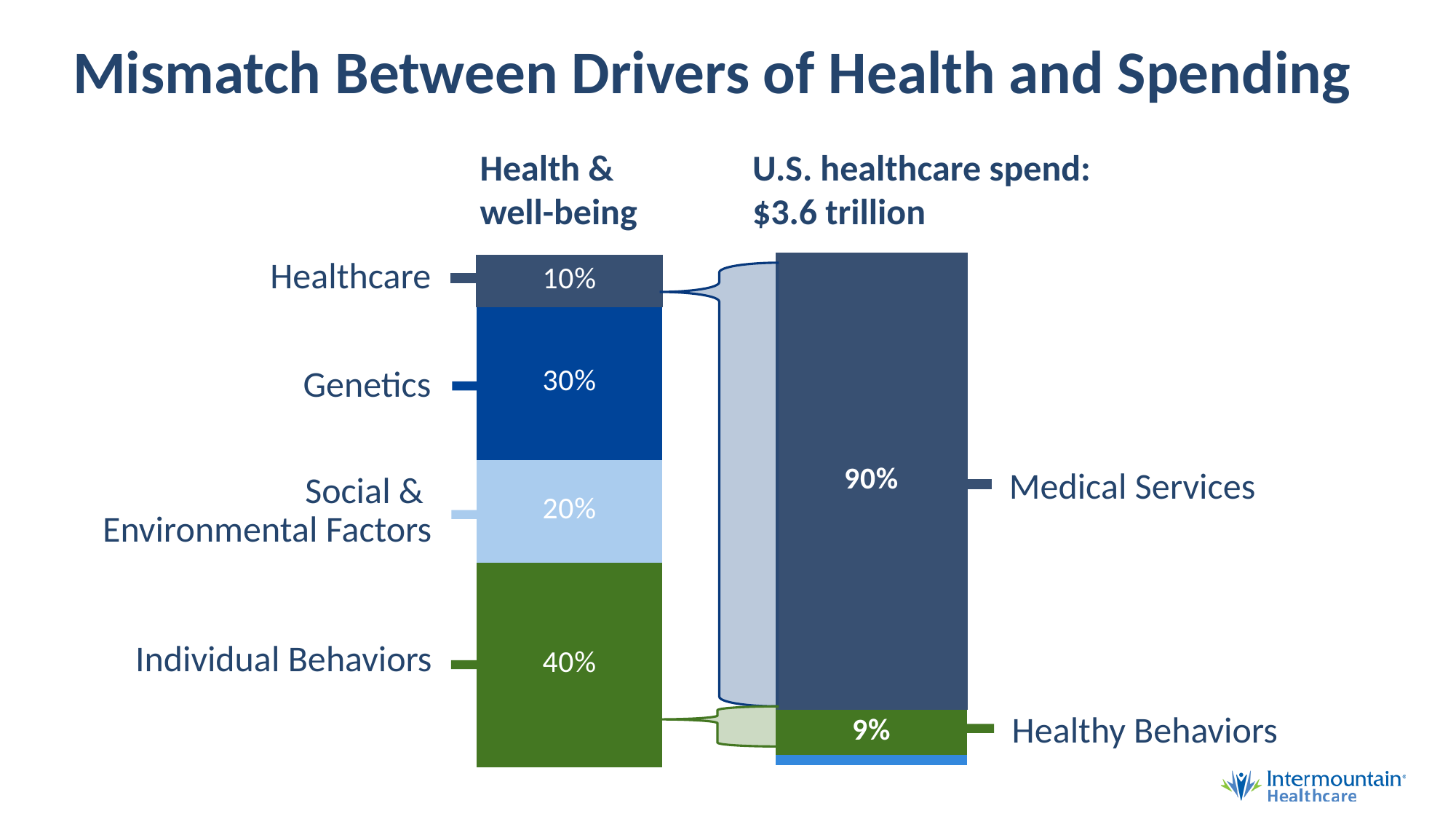
In the Health & well-being bar, which factor has the smallest share? Healthcare In the U.S. healthcare spend bar, what percentage goes to Medical Services? 90% In the Health & well-being bar, what percentage is attributed to Genetics? 30% In the Health & well-being bar, what percentage is attributed to Individual Behaviors? 40% In the Health & well-being bar, which factor has the largest share? Individual Behaviors In the U.S. healthcare spend bar, what percentage goes to Healthy Behaviors? 9% In the Health & well-being bar, what percentage is attributed to Social & Environmental Factors? 20% What total U.S. healthcare spend is stated above the right-hand bar? $3.6 trillion What is the difference between the Individual Behaviors share of health & well-being and the Healthy Behaviors share of U.S. healthcare spend? 31% How many labeled segments make up the Health & well-being bar? 4 Which is larger in the Health & well-being bar: Genetics or Social & Environmental Factors? Genetics In the Health & well-being bar, what percentage is attributed to Healthcare? 10%